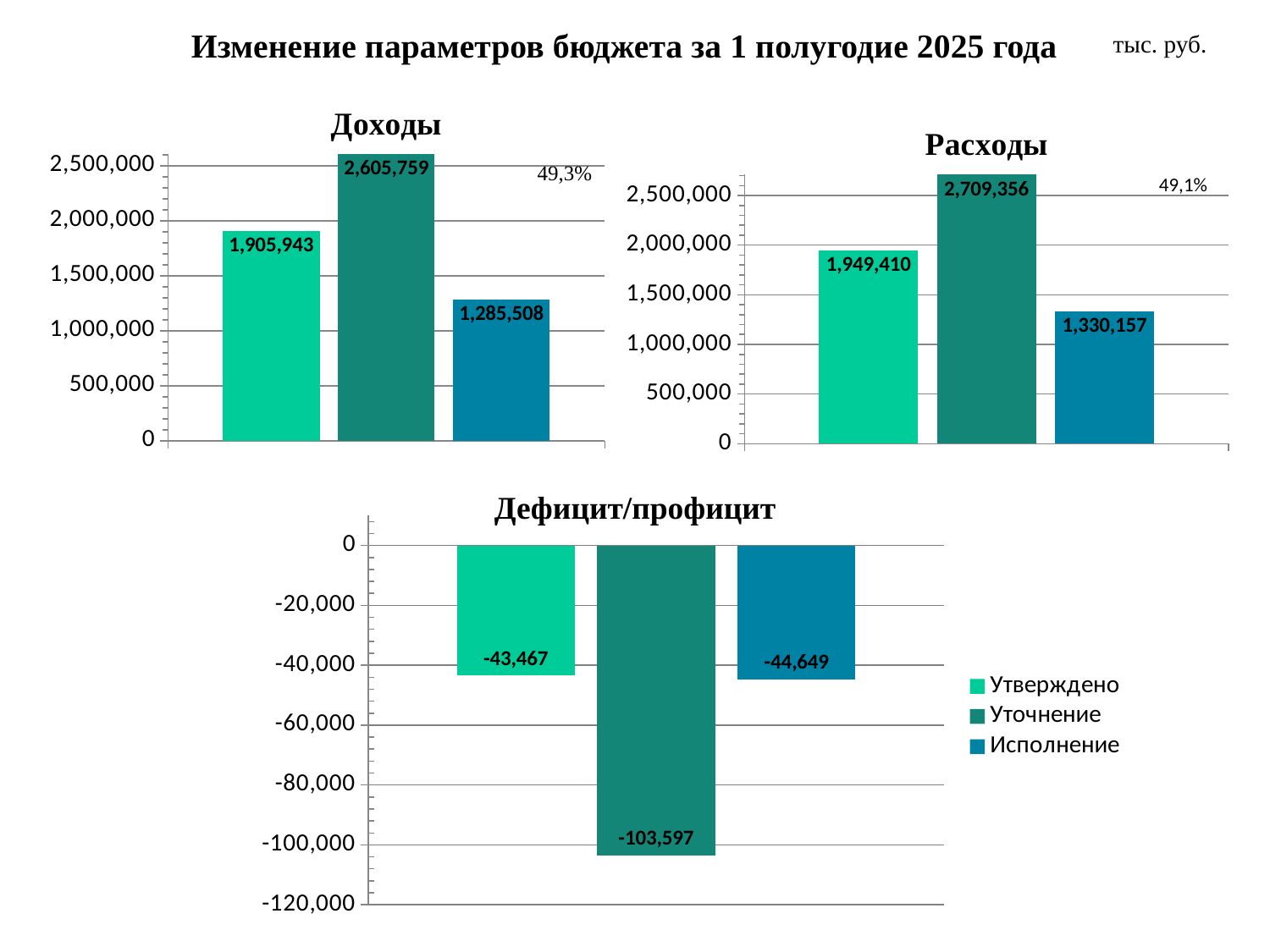
How many series does the legend list? 3 Which is larger: the Исполнение value in the "Доходы" chart or the Исполнение value in the "Расходы" chart? Расходы In the "Дефицит/профицит" chart, what is the value for Уточнение? -103,597 What kind of chart is the "Дефицит/профицит" chart? bar chart In the "Доходы" chart, which series has the lowest value? Исполнение In the "Доходы" chart, what is the value for Исполнение? 1,285,508 In the "Дефицит/профицит" chart, is the value for Уточнение greater or less than -100,000? less In the "Расходы" chart, what is the value for Утверждено? 1,949,410 In the "Доходы" chart, what is the value for Уточнение? 2,605,759 In the "Расходы" chart, what is the difference between the Утверждено value and the Исполнение value? 619,253 In the "Доходы" chart, what is the difference between the Уточнение value and the Утверждено value? 699,816 In the "Расходы" chart, which series has the highest value? Уточнение